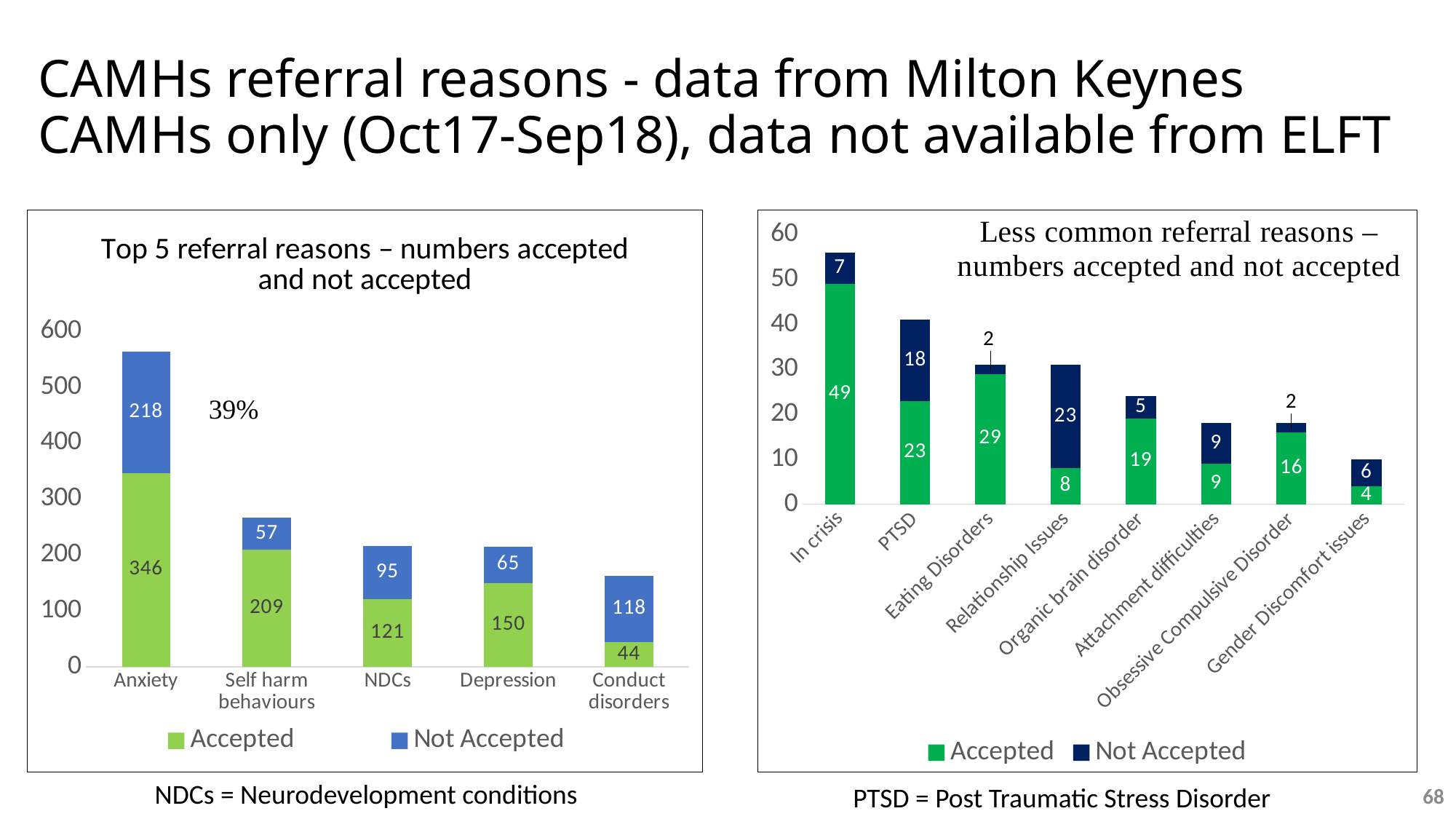
In the 'Less common referral reasons' chart, which is larger: the number of accepted Eating Disorders referrals or the number of accepted Organic brain disorder referrals? Eating Disorders In the 'Top 5 referral reasons' chart, how many Conduct disorders referrals were not accepted? 118 In the 'Less common referral reasons' chart, which category has the highest number of accepted referrals? In crisis In the 'Less common referral reasons' chart, how many In crisis referrals were accepted? 49 In the 'Less common referral reasons' chart, how many Relationship Issues referrals were not accepted? 23 In the 'Top 5 referral reasons' chart, how many Anxiety referrals were accepted? 346 In the 'Top 5 referral reasons' chart, what is the difference between accepted Self harm behaviours referrals and accepted NDCs referrals? 88 In the 'Less common referral reasons' chart, what is the total number of PTSD referrals (accepted plus not accepted)? 41 In the 'Top 5 referral reasons' chart, which category has the lowest number of accepted referrals? Conduct disorders What type of chart is the 'Less common referral reasons' chart? Stacked bar chart In the 'Top 5 referral reasons' chart, how many categories are shown on the x axis? 5 In the 'Top 5 referral reasons' chart, what is the total number of Anxiety referrals (accepted plus not accepted)? 564